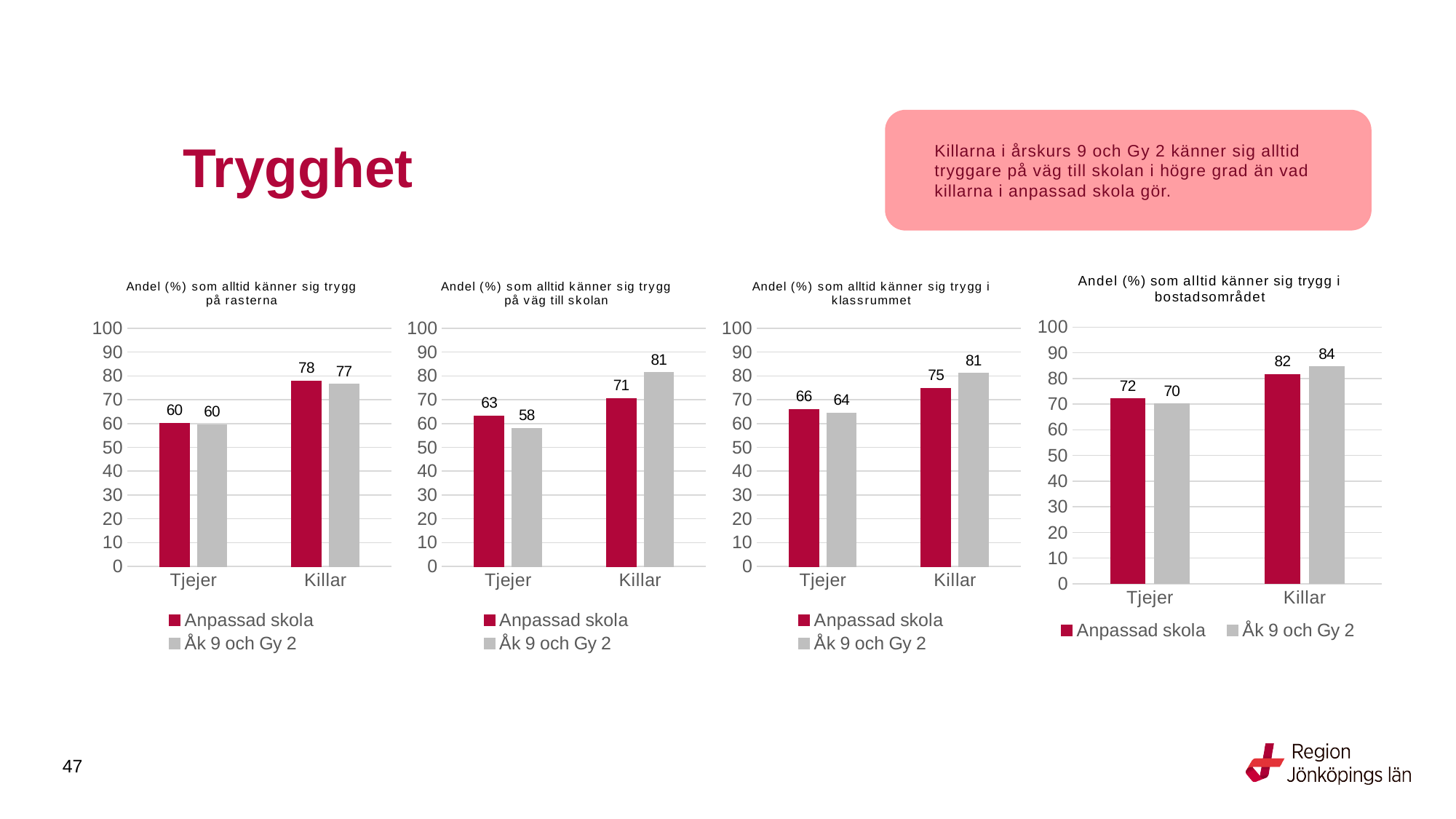
In the chart 'Andel (%) som alltid känner sig trygg på väg till skolan', what is the value for Tjejer in the Åk 9 och Gy 2 series? 58 In the chart 'Andel (%) som alltid känner sig trygg i bostadsområdet', what is the value for Tjejer in the Anpassad skola series? 72 How many categories are shown on the x axis of the chart 'Andel (%) som alltid känner sig trygg i klassrummet'? 2 In the chart 'Andel (%) som alltid känner sig trygg i klassrummet', what is the value for Killar in the Åk 9 och Gy 2 series? 81 How many series does the legend list in the chart 'Andel (%) som alltid känner sig trygg på rasterna'? 2 In the chart 'Andel (%) som alltid känner sig trygg på väg till skolan', what is the difference between the Åk 9 och Gy 2 and Anpassad skola values for Killar? 10 In the chart 'Andel (%) som alltid känner sig trygg på rasterna', what is the value for Killar in the Anpassad skola series? 78 In the chart 'Andel (%) som alltid känner sig trygg i bostadsområdet', which bar has the highest value? Killar, Åk 9 och Gy 2 What kind of chart is 'Andel (%) som alltid känner sig trygg i bostadsområdet'? Bar chart In the chart 'Andel (%) som alltid känner sig trygg i klassrummet', which is larger for Tjejer: Anpassad skola or Åk 9 och Gy 2? Anpassad skola In the chart 'Andel (%) som alltid känner sig trygg på väg till skolan', which bar has the lowest value? Tjejer, Åk 9 och Gy 2 In the chart 'Andel (%) som alltid känner sig trygg på rasterna', what is the difference between the Killar and Tjejer values in the Anpassad skola series? 18